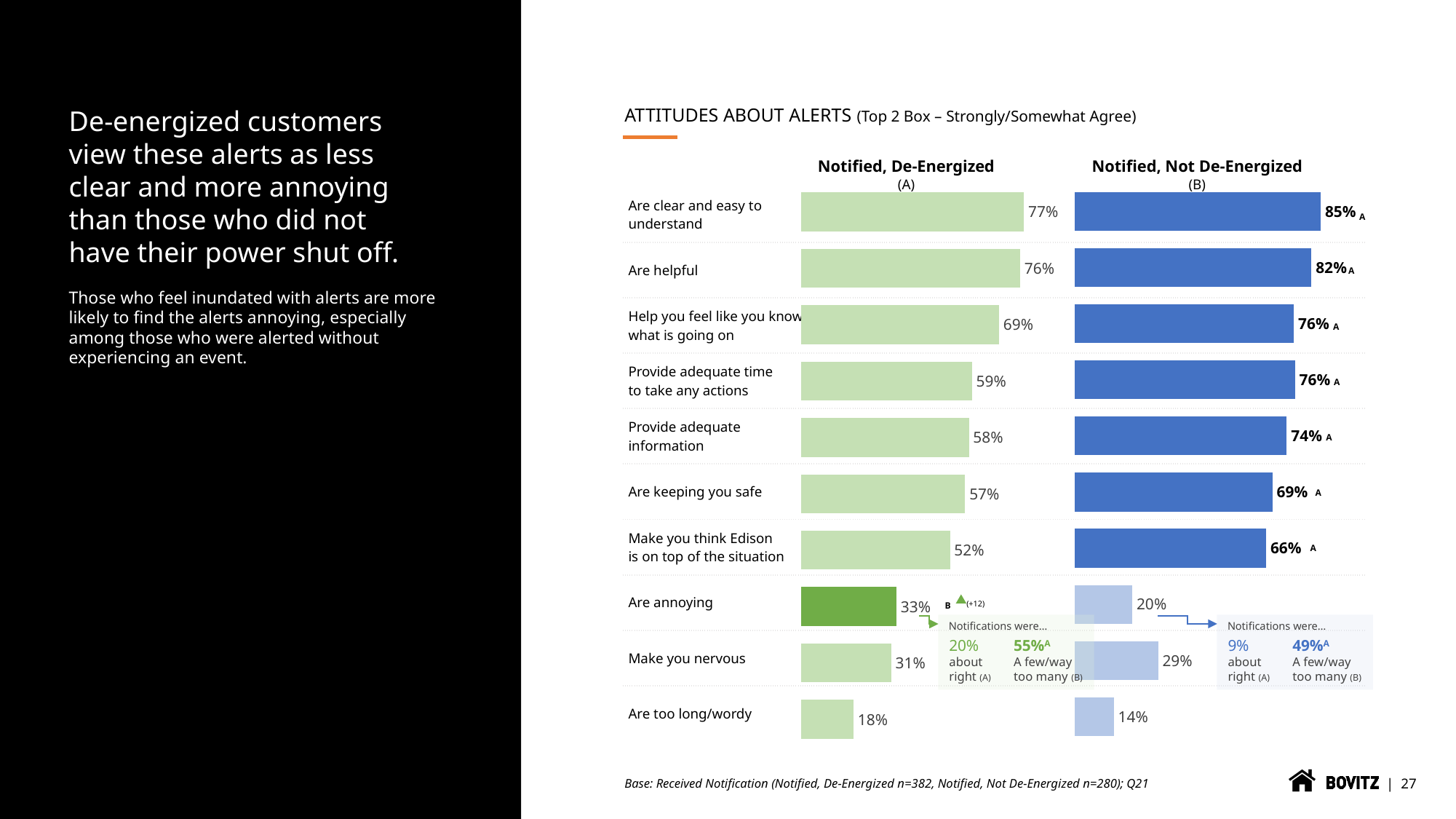
Which group has a higher percentage agreeing that alerts are keeping you safe? Notified, Not De-Energized What percentage of Notified, Not De-Energized customers agree that alerts are helpful? 82% Which attitude statement has the highest agreement among Notified, De-Energized customers? Are clear and easy to understand How many attitude statements are shown in the chart? 10 How many respondent groups are compared in the chart? 2 Which attitude statement has the lowest agreement among Notified, Not De-Energized customers? Are too long/wordy What percentage of Notified, De-Energized customers agree that alerts are clear and easy to understand? 77% What type of chart is used to show attitudes about alerts? Bar chart Which group has a higher percentage agreeing that alerts make you nervous? Notified, De-Energized What percentage of Notified, Not De-Energized customers agree that alerts are annoying? 20% What is the difference between the two groups for 'Provide adequate time to take any actions'? 17 percentage points What is the difference between the Notified, Not De-Energized and Notified, De-Energized percentages for 'Are annoying'? 13 percentage points